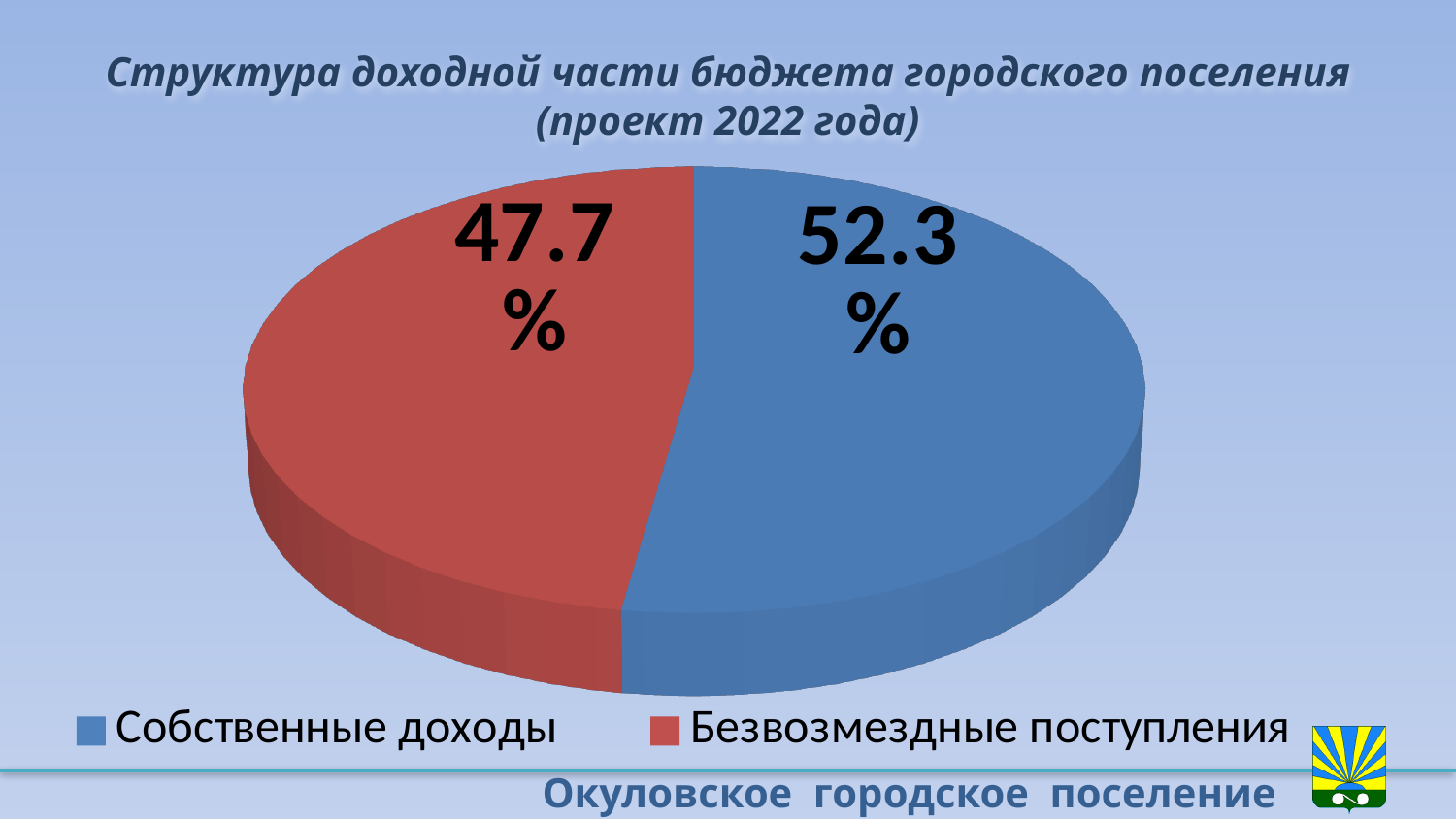
Which category has the smallest slice of the pie? Безвозмездные поступления What colour is the slice for Безвозмездные поступления? Red What share of the pie does Собственные доходы represent? 52.3% What share of the pie does Безвозмездные поступления represent? 47.7% How many entries does the legend list? 2 Which category has the largest slice of the pie? Собственные доходы What kind of chart is shown on the slide? Pie chart What is the title of the chart? Структура доходной части бюджета городского поселения (проект 2022 года) Is the share for Собственные доходы greater or less than 50%? greater What is the difference in percentage points between Собственные доходы and Безвозмездные поступления? 4.6 Which is larger, Собственные доходы or Безвозмездные поступления? Собственные доходы How many slices does the pie chart have? 2